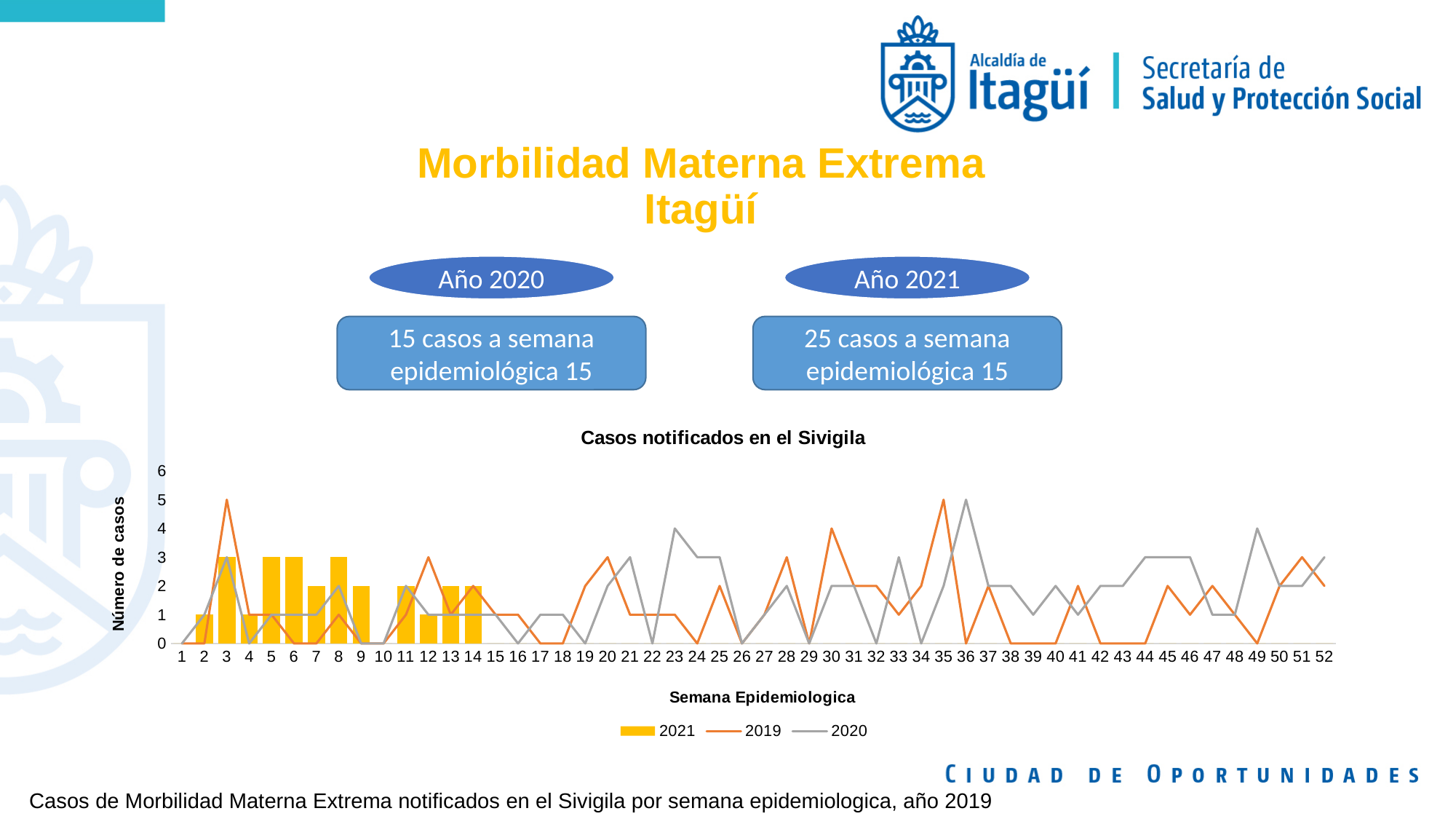
What kind of chart is 'Casos notificados en el Sivigila'? A combined bar and line chart How many series does the legend of the chart list? 3 What is the highest value reached by the 2019 line? 5 How many epidemiological weeks are shown on the x axis of the chart? 52 What is the value of the 2021 bar at week 3? 3 At week 3, which is larger: the 2019 value or the 2021 value? 2019 What is the value of the 2021 bar at week 7? 2 What is the title of the vertical axis of the chart? Número de casos Which series are listed in the chart legend? 2021, 2019, 2020 What is the difference between the 2019 value and the 2021 value at week 3? 2 What is the value of the 2020 line at week 36? 5 What is the value of the 2021 bar at week 12? 1